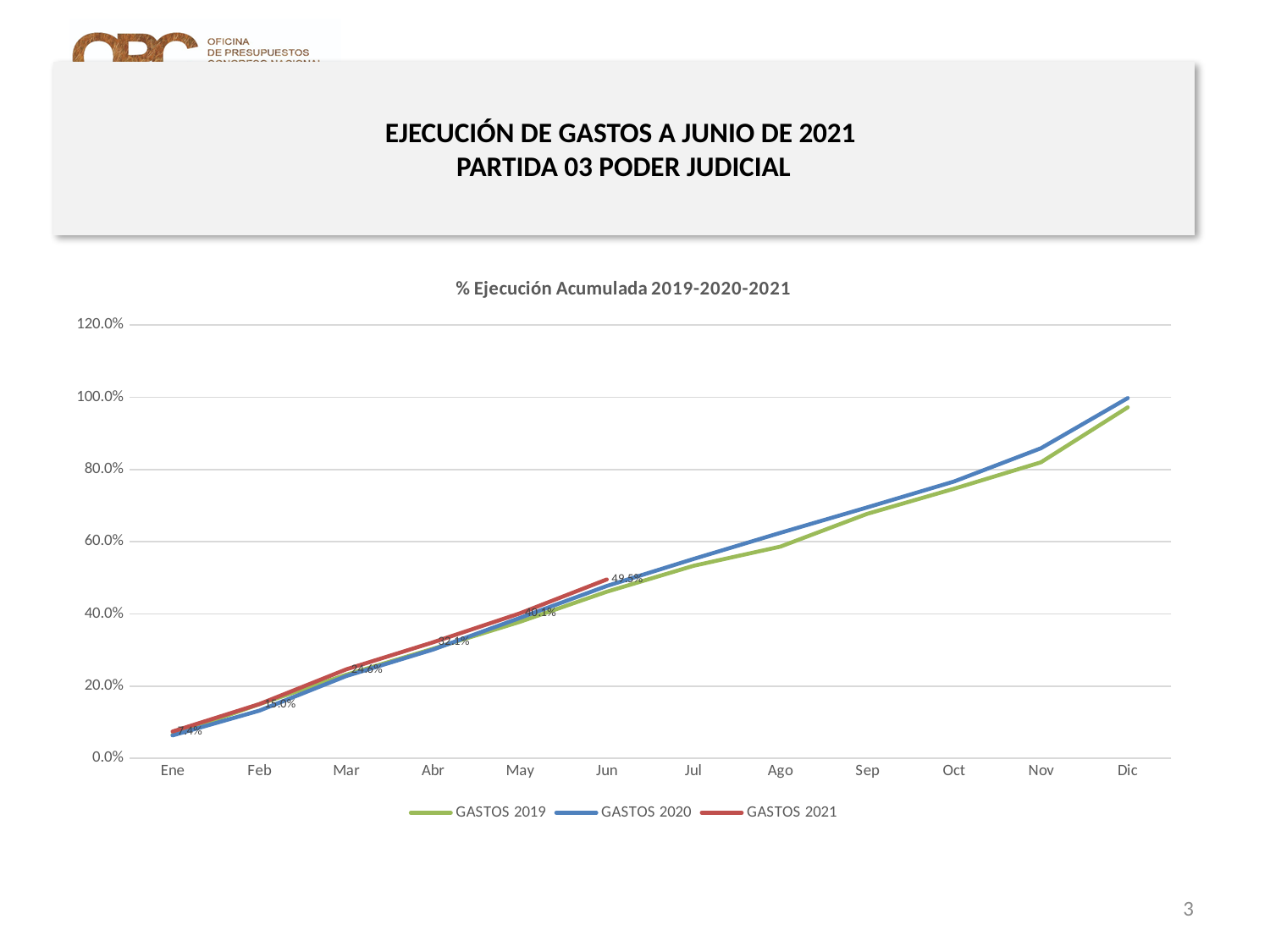
What is the title of the chart? % Ejecución Acumulada 2019-2020-2021 Is the value for GASTOS 2019 in Dic greater or less than 80.0%? greater What is the value for GASTOS 2021 in Mar? 24.6% In which month does the GASTOS 2021 series reach its highest value? Jun What is the value for GASTOS 2021 in Ene? 7.4% What kind of chart is shown on the slide? Line chart How many months are shown along the x axis? 12 How many series does the legend list? 3 What is the difference between the GASTOS 2021 values for Jun and Ene? 42.1 percentage points What is the value for GASTOS 2021 in Jun? 49.5% What is the value for GASTOS 2021 in Abr? 32.1% Do the values for GASTOS 2020 rise or fall from Ene to Dic? Rise